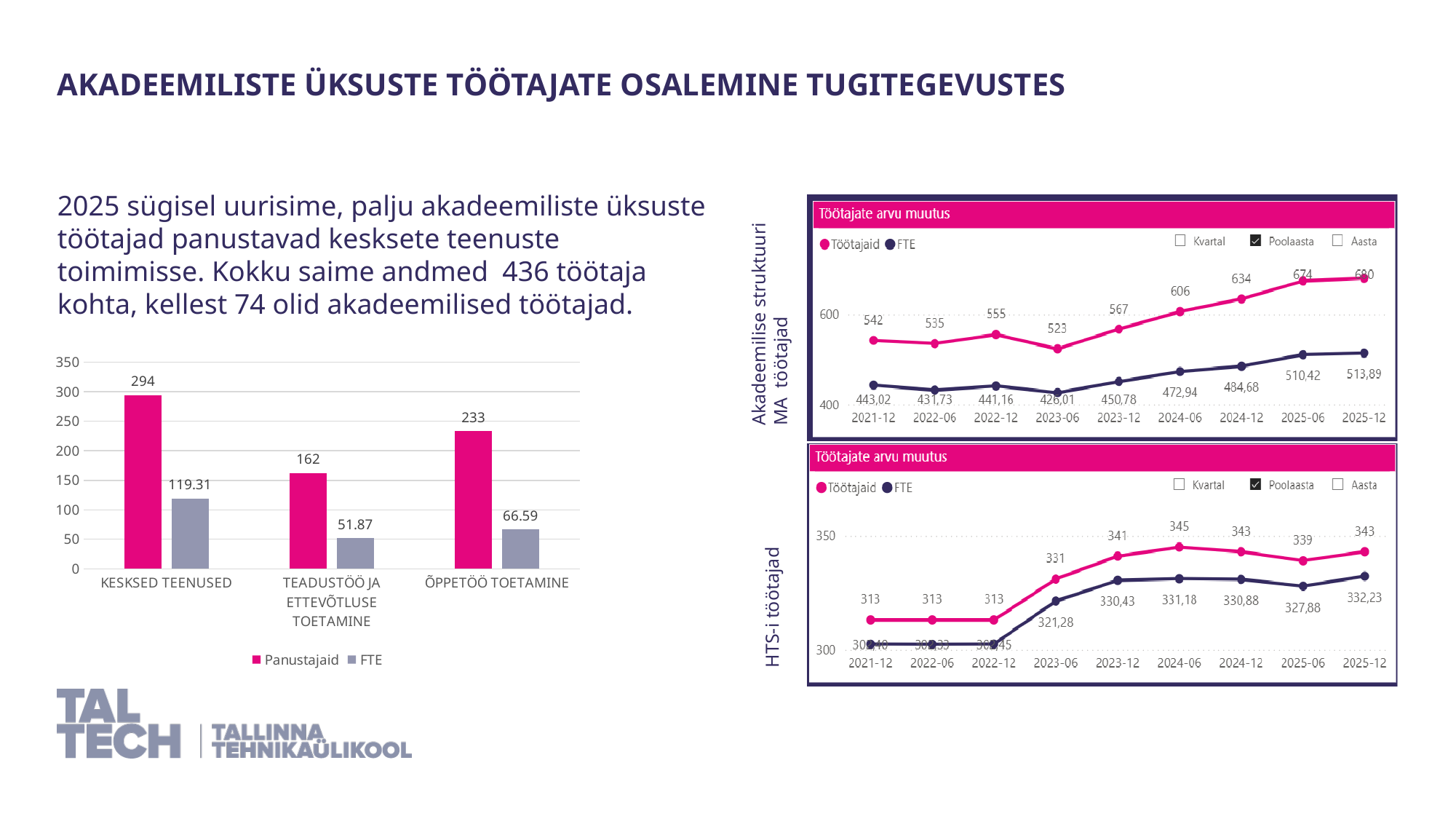
In the top right line chart (Akadeemilise struktuuri MA töötajad), what is the Töötajaid value for 2024-06? 606 How many dates are shown on the x axis of the bottom right line chart (HTS-i töötajad)? 9 How many series does the legend of the bar chart on the left list? 2 In the bottom right line chart (HTS-i töötajad), what is the Töötajaid value for 2024-06? 345 In the top right line chart (Akadeemilise struktuuri MA töötajad), does the Töötajaid line rise or fall from 2023-06 to 2025-12? Rise In the bar chart on the left, what is the Panustajaid value for KESKSED TEENUSED? 294 In the bar chart on the left, which category has the highest Panustajaid value? KESKSED TEENUSED What kind of chart is the chart on the left of the slide? Bar chart In the top right line chart (Akadeemilise struktuuri MA töötajad), what is the FTE value for 2025-12? 513,89 In the bar chart on the left, what is the difference between the Panustajaid values for KESKSED TEENUSED and ÕPPETÖÖ TOETAMINE? 61 In the top right line chart (Akadeemilise struktuuri MA töötajad), at which date is the Töötajaid value lowest? 2023-06 In the bar chart on the left, what is the FTE value for TEADUSTÖÖ JA ETTEVÕTLUSE TOETAMINE? 51.87